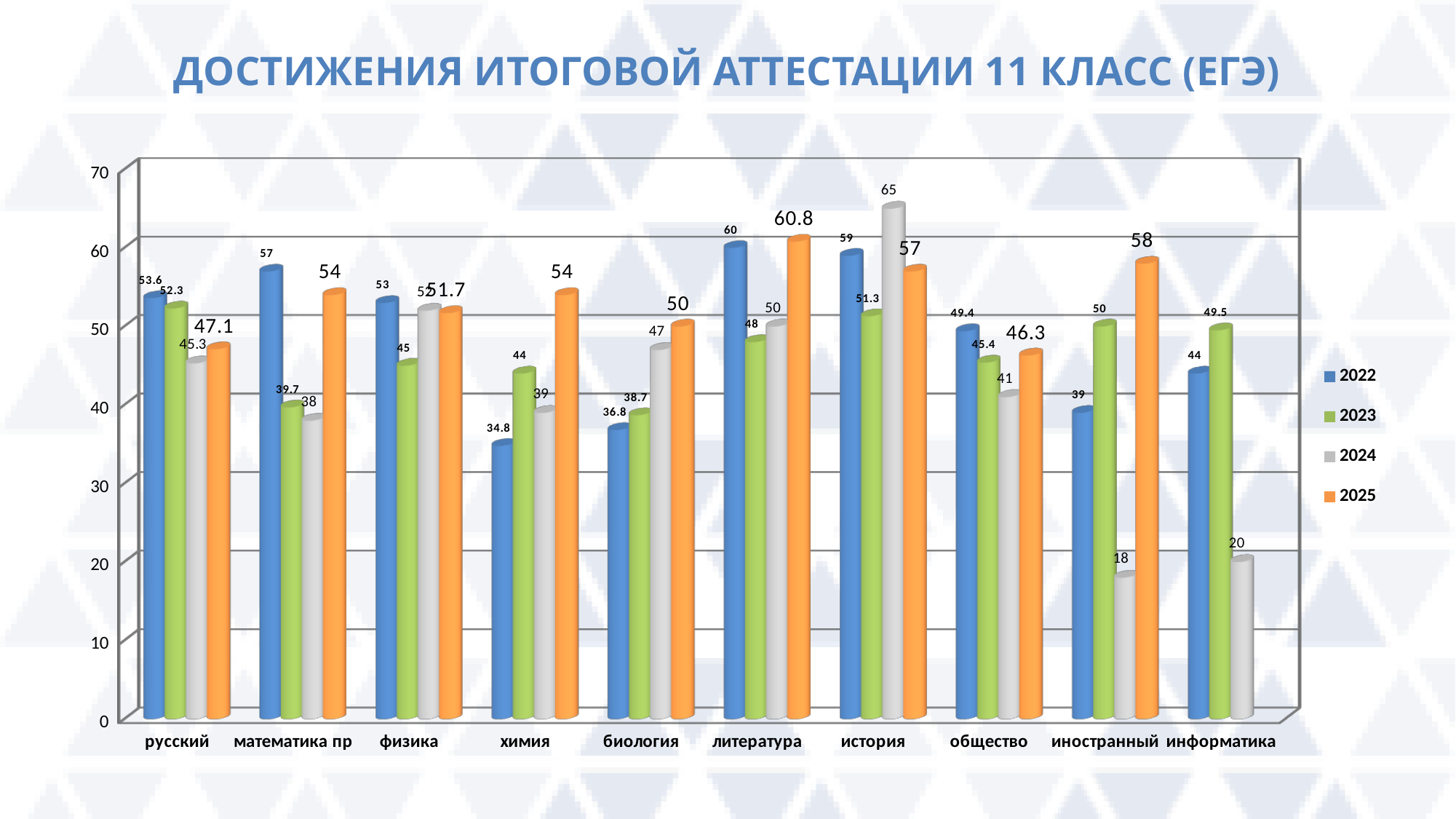
Do the values for биология rise or fall from 2022 to 2025? rise For химия, which year has the larger value, 2022 or 2025? 2025 How many series does the legend list? 4 What kind of chart is shown on the slide? bar chart What is the value for математика пр in 2022? 57 What is the value for литература in 2025? 60.8 Which subject has the highest value in the 2024 series? история Is the 2022 value for химия greater or less than 40? less What is the difference between the 2024 and 2023 values for история? 13.7 How many subjects are shown on the x axis? 10 Which subject has the lowest value in the 2024 series? иностранный What is the value for иностранный in 2024? 18